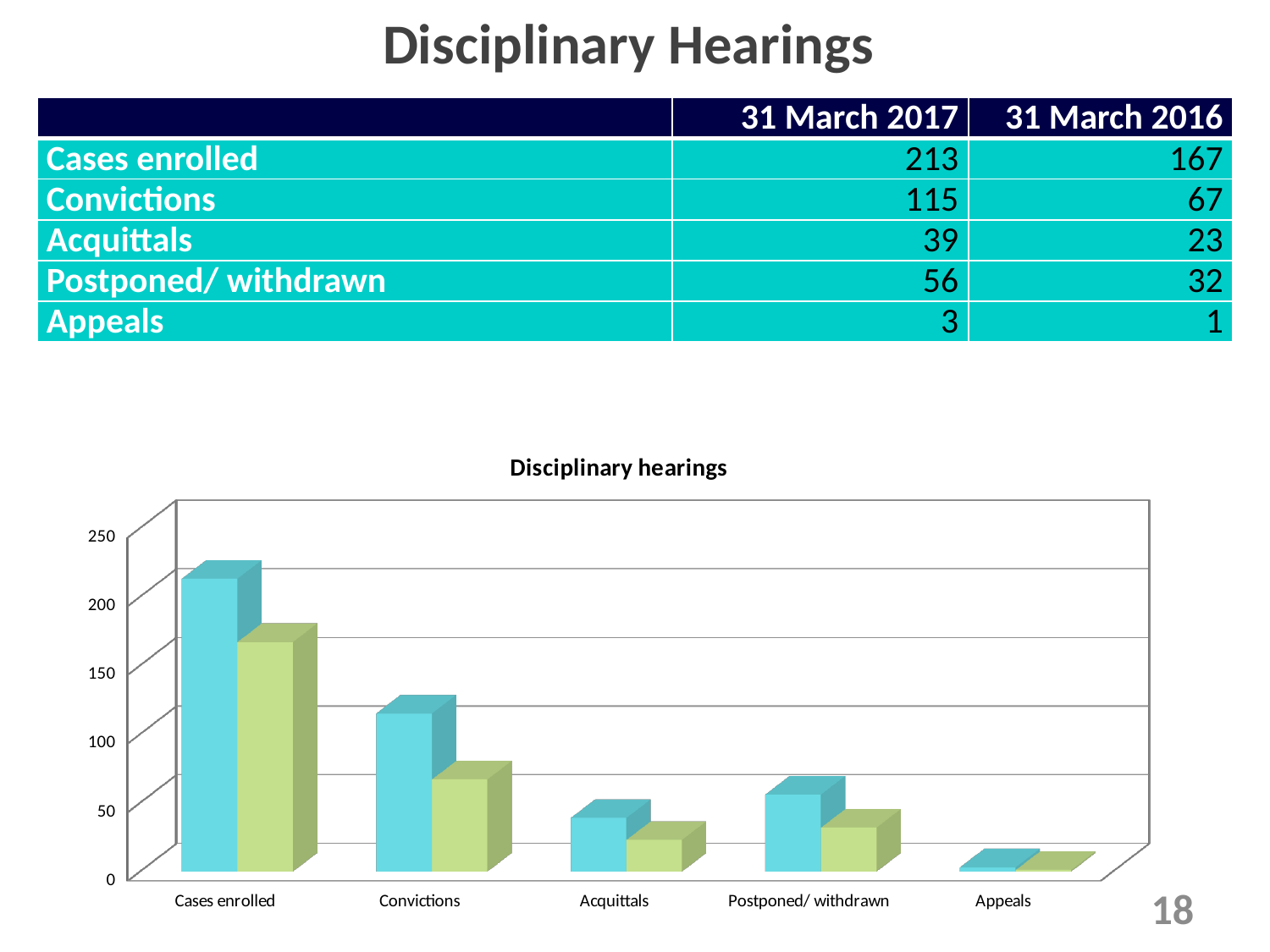
In the chart, is the first (blue) bar for Acquittals greater or less than 50? less Which category has the shortest bars in the chart? Appeals How many categories are shown on the x axis of the chart? 5 What kind of chart is shown on the slide? bar chart According to the table on the slide, what is the difference between Convictions at 31 March 2017 and at 31 March 2016? 48 In the chart, which is taller: the blue bar for Convictions or the blue bar for Postponed/ withdrawn? Convictions What is the title of the chart? Disciplinary hearings In the chart, is the second (green) bar for Cases enrolled greater or less than 200? less In the chart, is the first (blue) bar for Cases enrolled greater or less than 200? greater Which category has the tallest bars in the chart? Cases enrolled According to the table on the slide, how many cases were enrolled as at 31 March 2017? 213 Do the bar heights generally rise or fall from Cases enrolled to Appeals along the x axis? fall